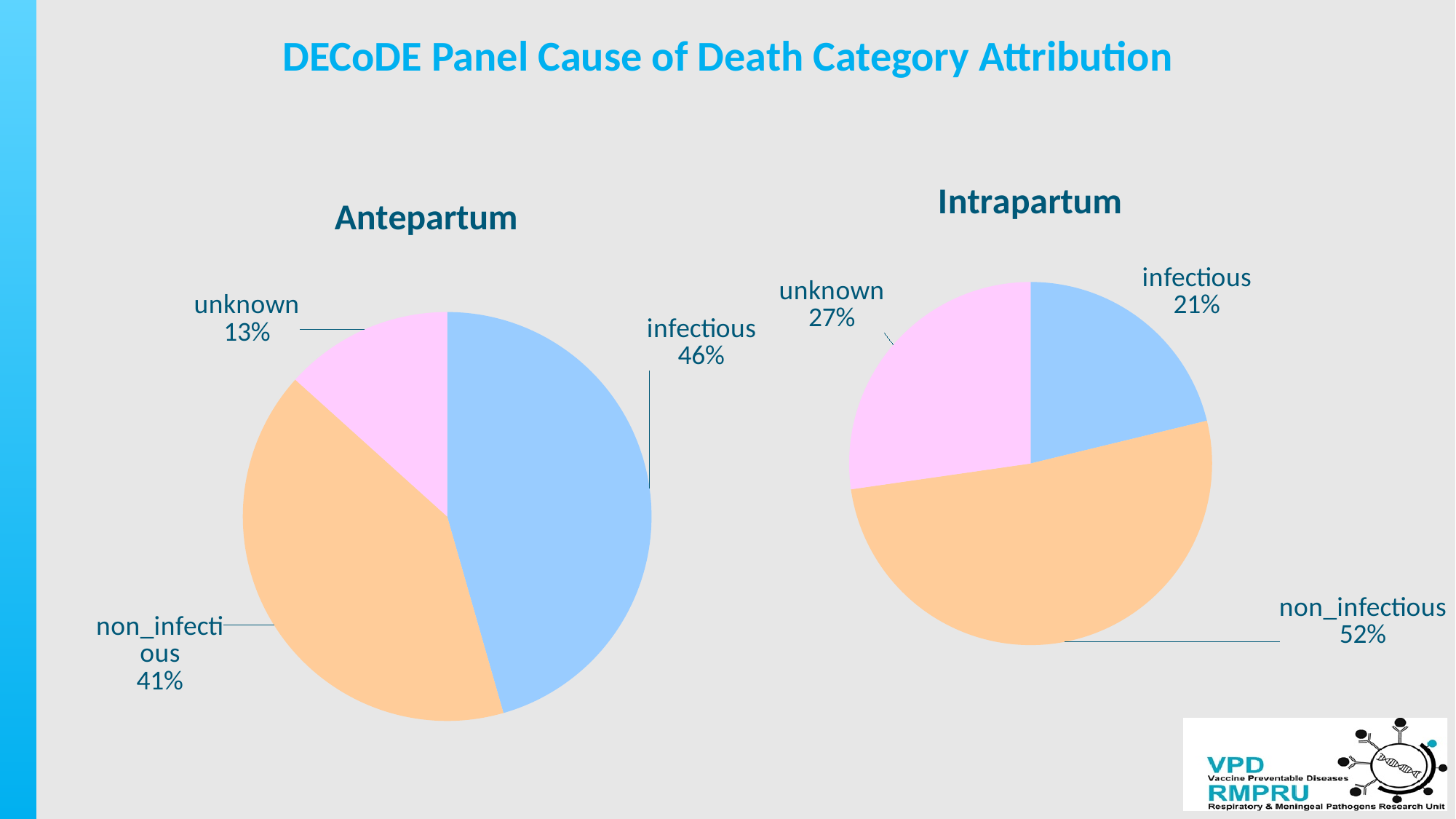
In the Antepartum chart, what is the difference between the infectious and non_infectious percentages? 5% In the Intrapartum chart, what is the difference between the non_infectious and unknown percentages? 25% In the Intrapartum chart, which category has the smallest slice? infectious In the Antepartum chart, which category has the largest slice? infectious What type of chart is the Antepartum chart? pie chart Which is larger: the unknown share in the Antepartum chart or the unknown share in the Intrapartum chart? Intrapartum In the Antepartum chart, what share of the pie is unknown? 13% In the Antepartum chart, what percentage is attributed to infectious causes? 46% In the Intrapartum chart, what percentage is attributed to non_infectious causes? 52% What is the title of the slide containing the two charts? DECoDE Panel Cause of Death Category Attribution In the Intrapartum chart, what share of the pie is unknown? 27% How many categories does the Intrapartum chart show? 3